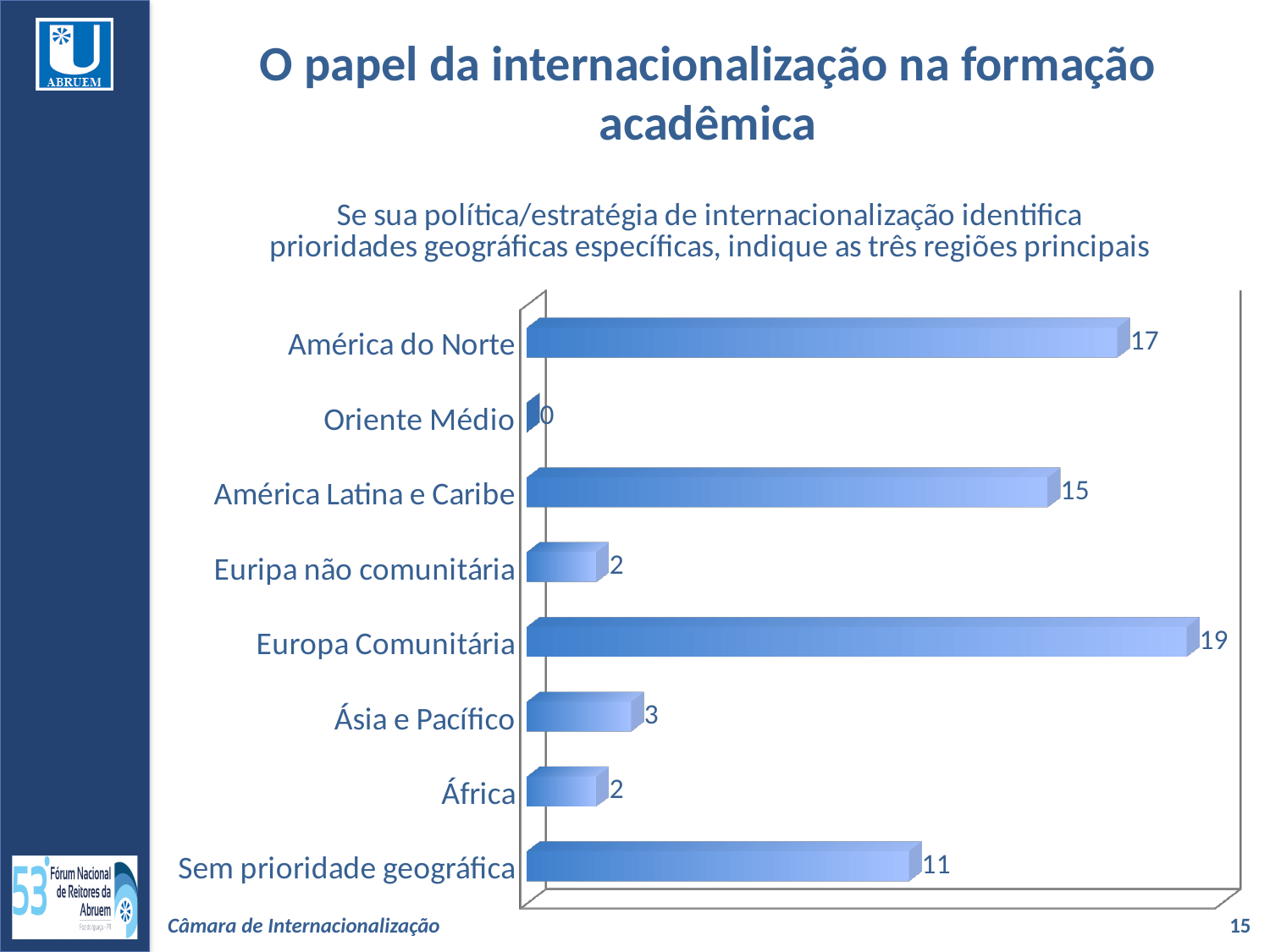
What is the difference between the values for Europa Comunitária and América Latina e Caribe? 4 Which is larger, the value for América do Norte or the value for América Latina e Caribe? América do Norte What kind of chart is shown on the slide? Bar chart What is the value for América do Norte? 17 What is the title of the chart? Se sua política/estratégia de internacionalização identifica prioridades geográficas específicas, indique as três regiões principais Which category has the highest value? Europa Comunitária What is the value for Sem prioridade geográfica? 11 How many categories are shown in the chart? 8 What is the difference between the values for Ásia e Pacífico and África? 1 Which category has the lowest value? Oriente Médio What is the value for Europa Comunitária? 19 What is the value for Oriente Médio? 0